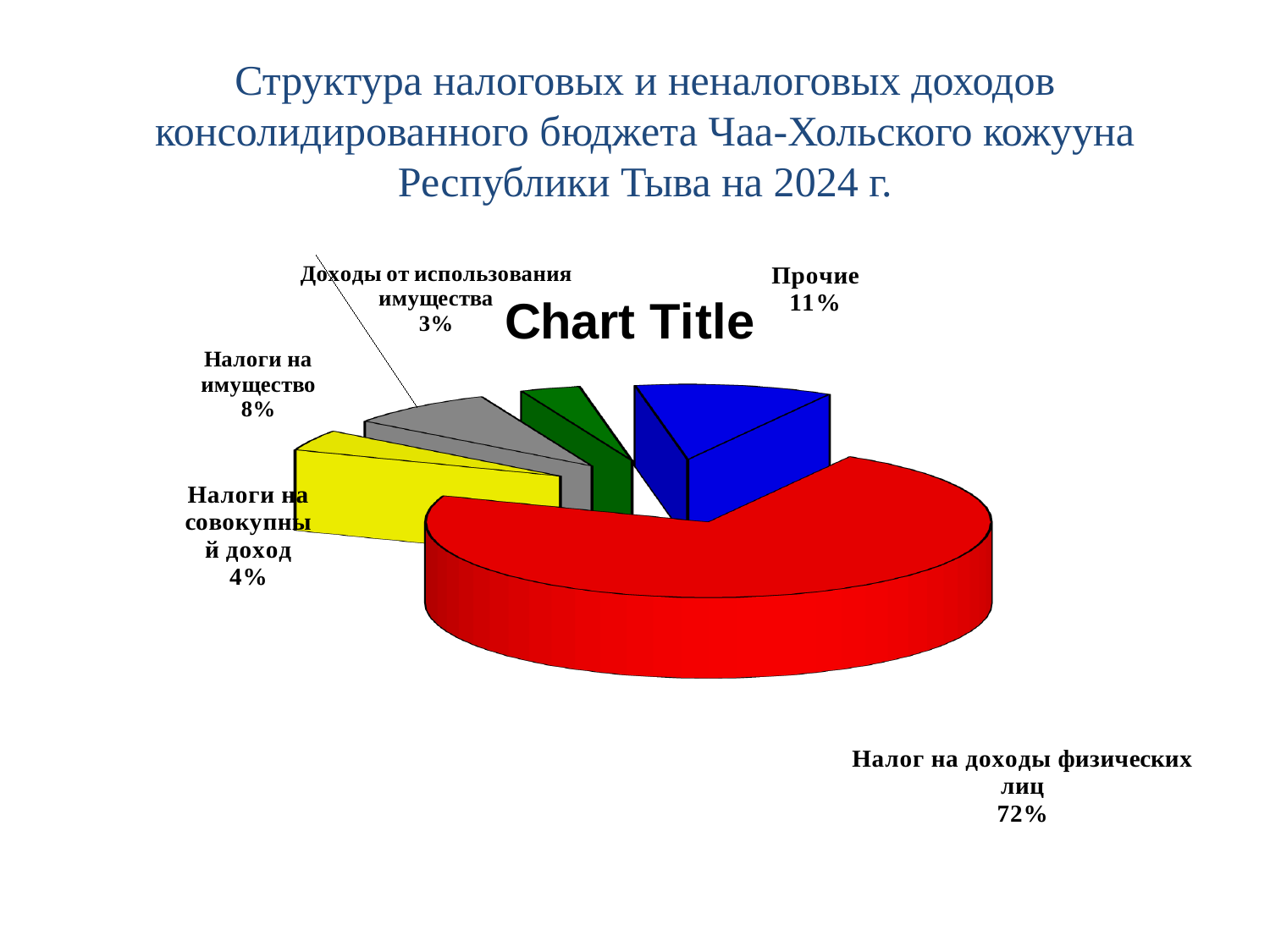
What share of the pie does "Прочие" have? 11% Which is larger, the share for "Налоги на имущество" or the share for "Налоги на совокупный доход"? Налоги на имущество How many slices does the pie chart have? 5 Which category has the largest share of the pie? Налог на доходы физических лиц What is the difference in percentage points between "Налог на доходы физических лиц" and "Прочие"? 61 What kind of chart is shown on the slide? pie chart Which category has the smallest share of the pie? Доходы от использования имущества What share of the pie does "Налоги на имущество" have? 8% What share of the pie does "Налог на доходы физических лиц" have? 72% What colour is the slice for "Налог на доходы физических лиц"? red